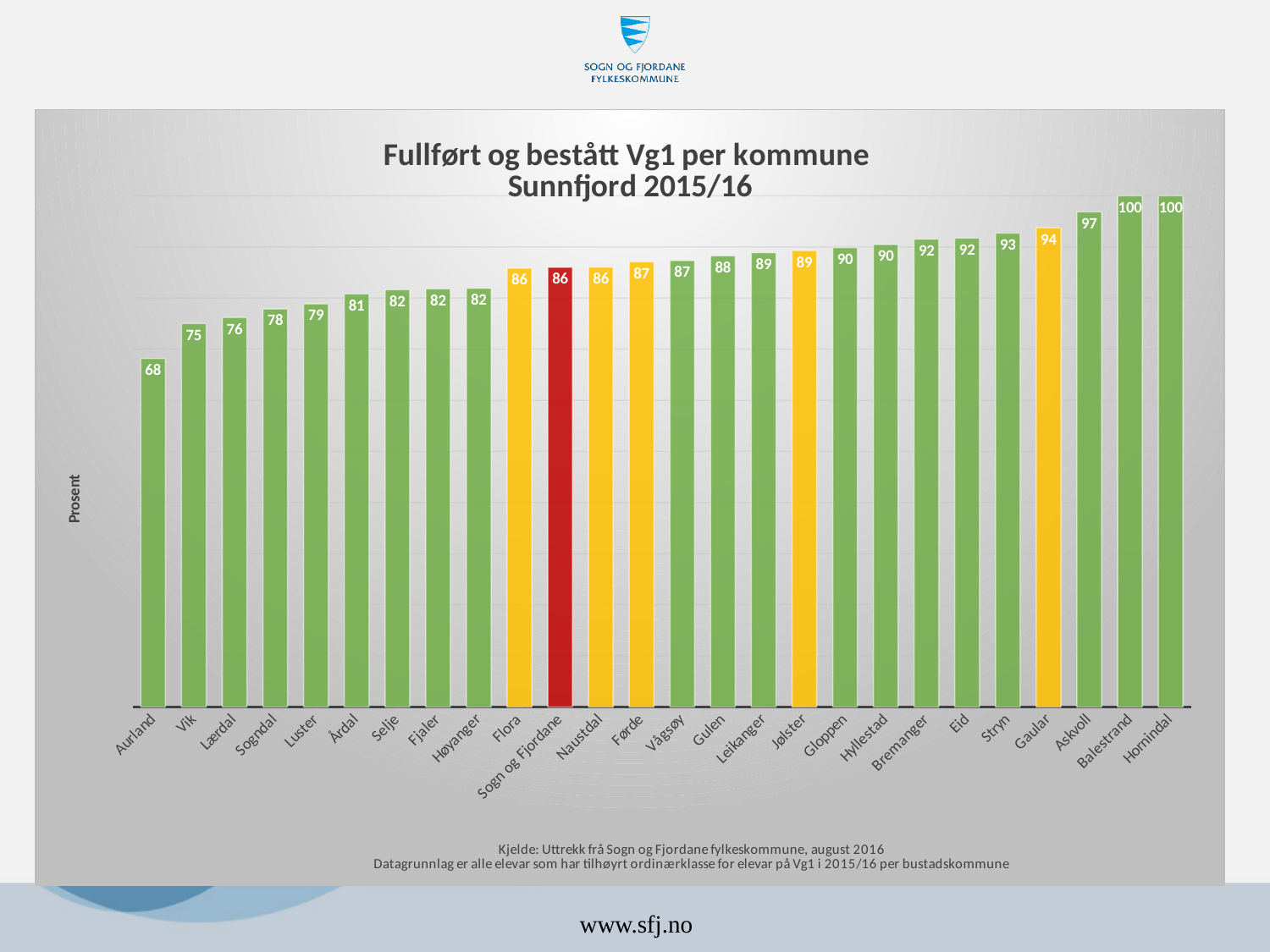
What is the value for Aurland? 68 What colour is the bar for Sogn og Fjordane? Red What kind of chart is this? Bar chart How many kommunes (bars) are shown in the chart? 26 Which has the larger value, Stryn or Eid? Stryn Which two kommunes share the highest value of 100? Balestrand and Hornindal What is the difference between the values for Gaular and Flora? 8 What is the value for Askvoll? 97 Which kommune has the lowest value? Aurland What is the value for Sogn og Fjordane? 86 What is the value for Gaular? 94 What is the difference between the values for Hornindal and Aurland? 32